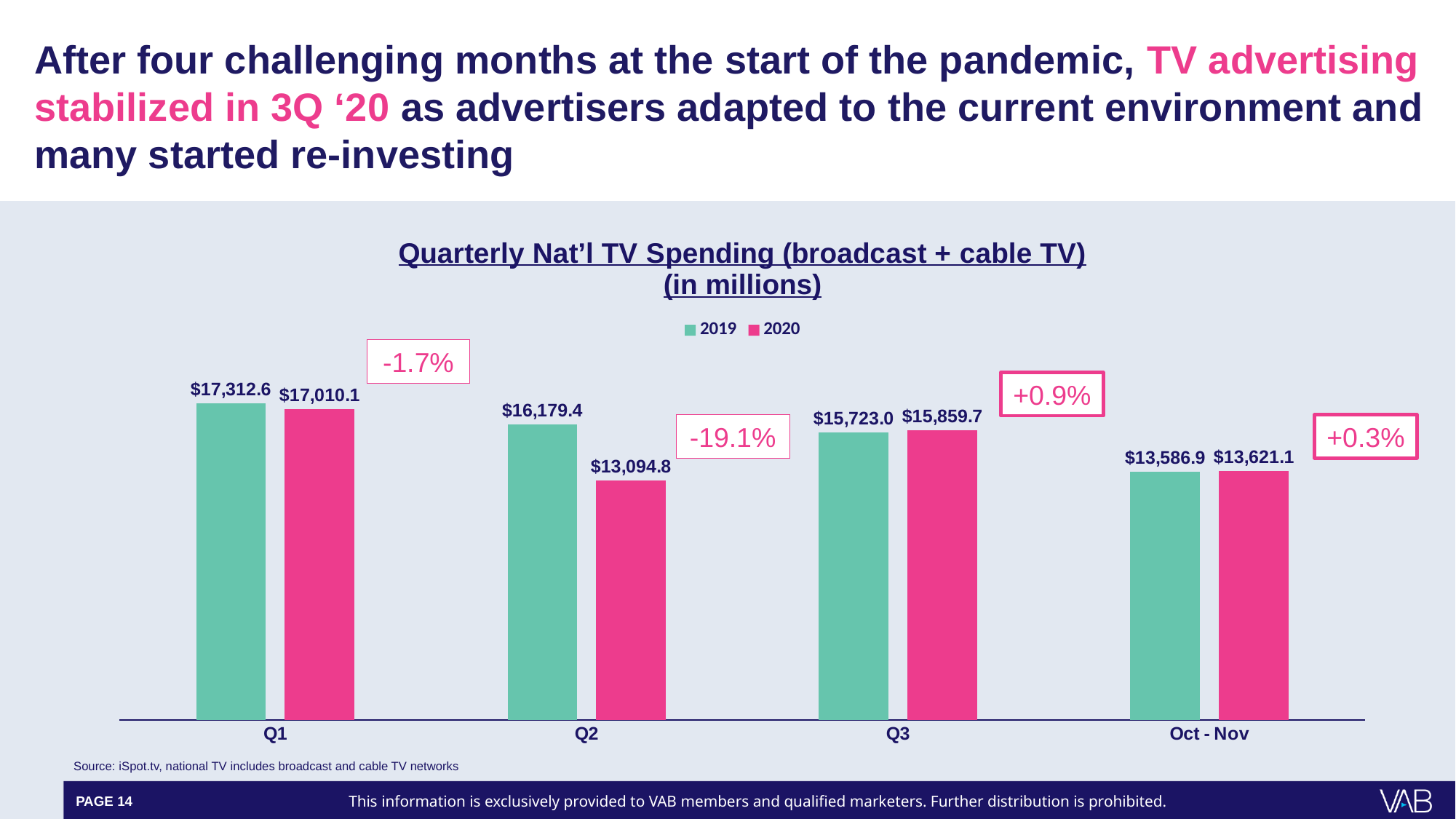
What is the 2020 value for Q3? $15,859.7 How many series does the legend list? 2 Which category has the lowest 2020 value? Q2 Which category has the highest 2019 value? Q1 Which is larger for Q3, the 2019 value or the 2020 value? 2020 What is the 2020 value for Oct - Nov? $13,621.1 What is the 2019 value for Q2? $16,179.4 Do the 2019 values rise or fall from Q1 to Oct - Nov? Fall What percentage change is shown in the box next to the Q2 bars? -19.1% What type of chart is shown on the slide? Bar chart What is the difference between the 2019 and 2020 values for Q2? $3,084.6 How many categories are shown on the x axis? 4